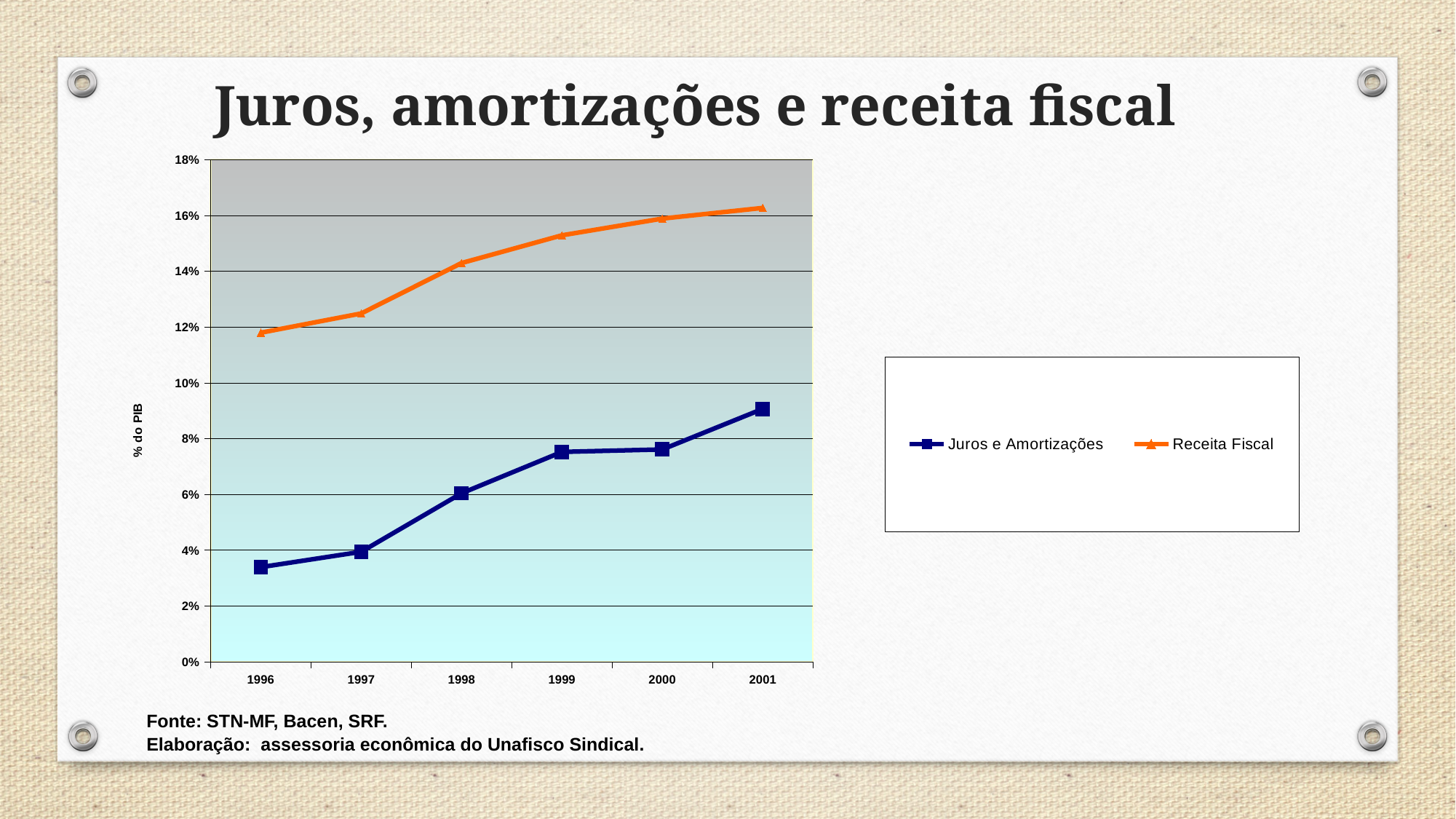
How many series does the legend list? 2 Is the value for Juros e Amortizações in 2001 greater or less than 8%? greater What kind of chart is shown on the slide? line chart How many years are plotted along the x axis? 6 Which series has the higher value in 1999, Juros e Amortizações or Receita Fiscal? Receita Fiscal Is the value for Juros e Amortizações in 1996 greater or less than 4%? less In which year is Receita Fiscal at its lowest? 1996 Does Receita Fiscal rise or fall from 1996 to 2001? rise What is the label on the y axis of the chart? % do PIB In which year is Juros e Amortizações at its highest? 2001